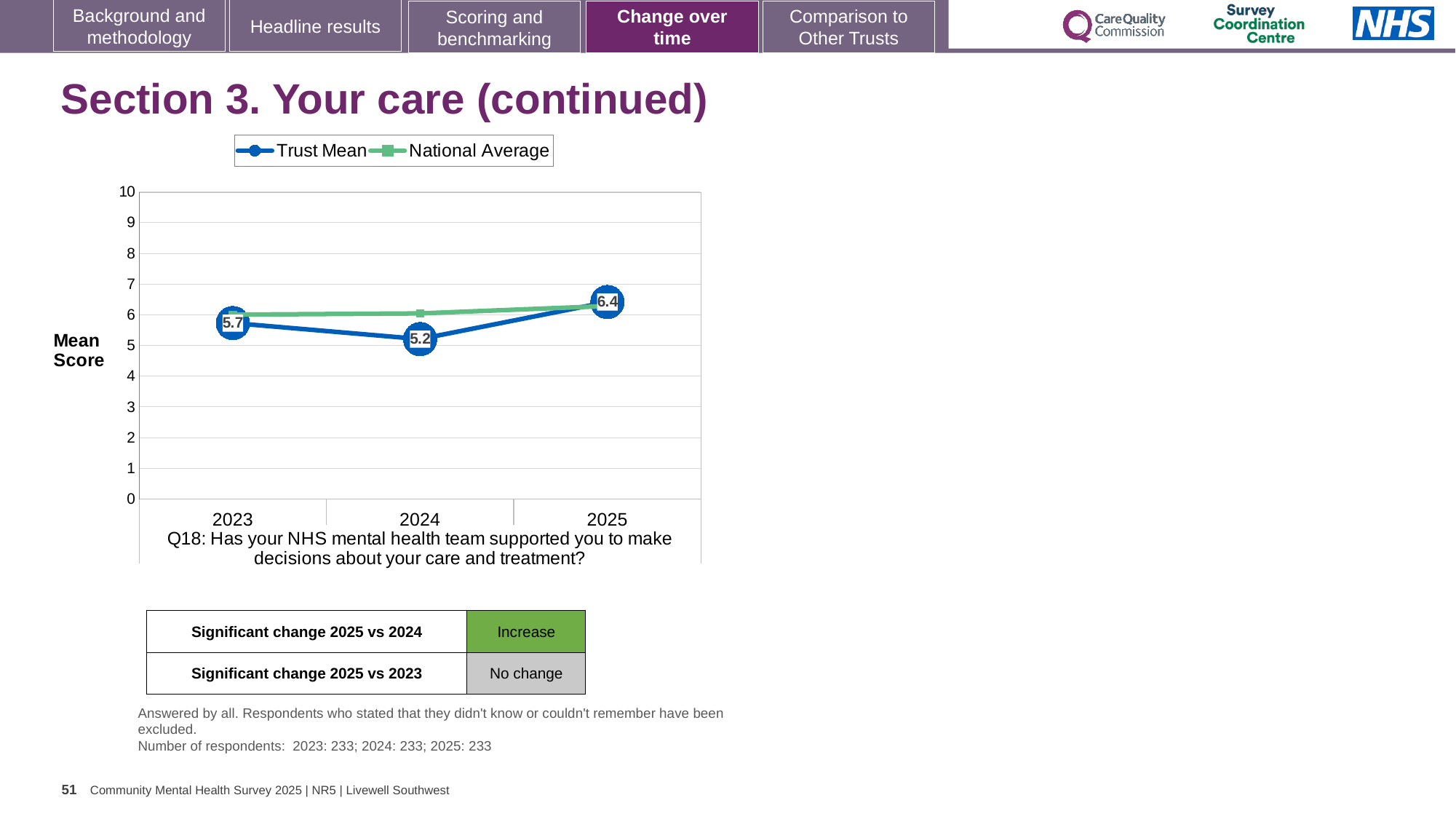
Is the National Average value for 2023 greater or less than 5? greater Between 2024 and 2025, does the Trust Mean rise or fall? rise Which is larger, the Trust Mean in 2023 or the Trust Mean in 2024? 2023 What is the Trust Mean score for 2025? 6.4 How many series does the legend list? 2 What is the Trust Mean score for 2024? 5.2 In which year is the Trust Mean lowest? 2024 In which year is the Trust Mean highest? 2025 What is the Trust Mean score for 2023? 5.7 What kind of chart is shown? line chart What is the difference between the Trust Mean in 2025 and in 2024? 1.2 How many years are plotted on the x axis? 3